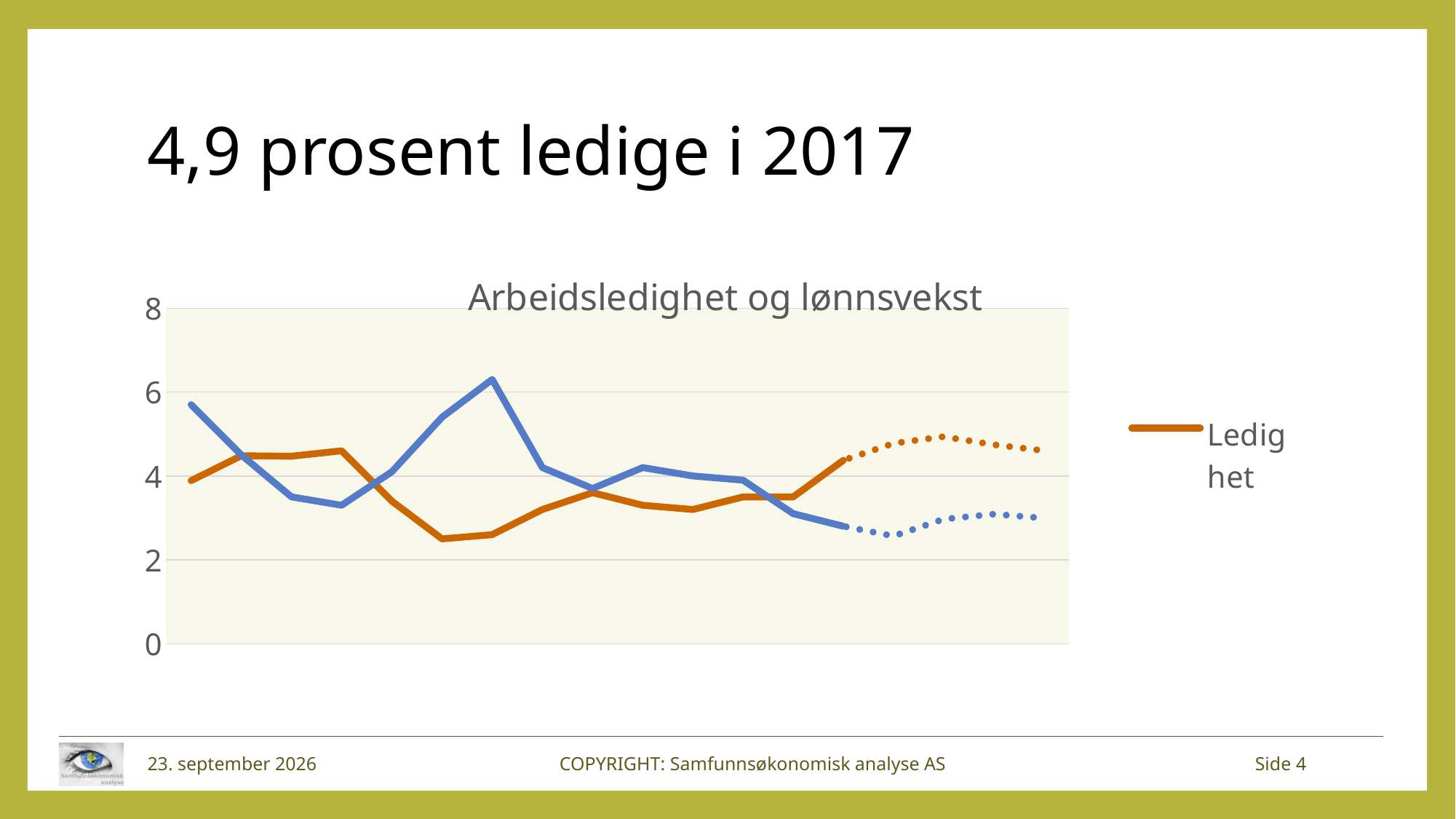
What is the title of the chart? Arbeidsledighet og lønnsvekst What colour is the line for the Ledighet series? orange What is the highest value shown on the vertical axis? 8 Is the highest point of the orange Ledighet line greater or less than 6? less Is the highest point of the blue line greater or less than 6? greater At the right end of the chart, which line is higher, the blue line or the orange Ledighet line? the orange Ledighet line Is the lowest point of the blue line greater or less than 2? greater At the left edge of the chart, which line starts higher, the blue line or the orange Ledighet line? the blue line What kind of chart is shown on the slide? line chart